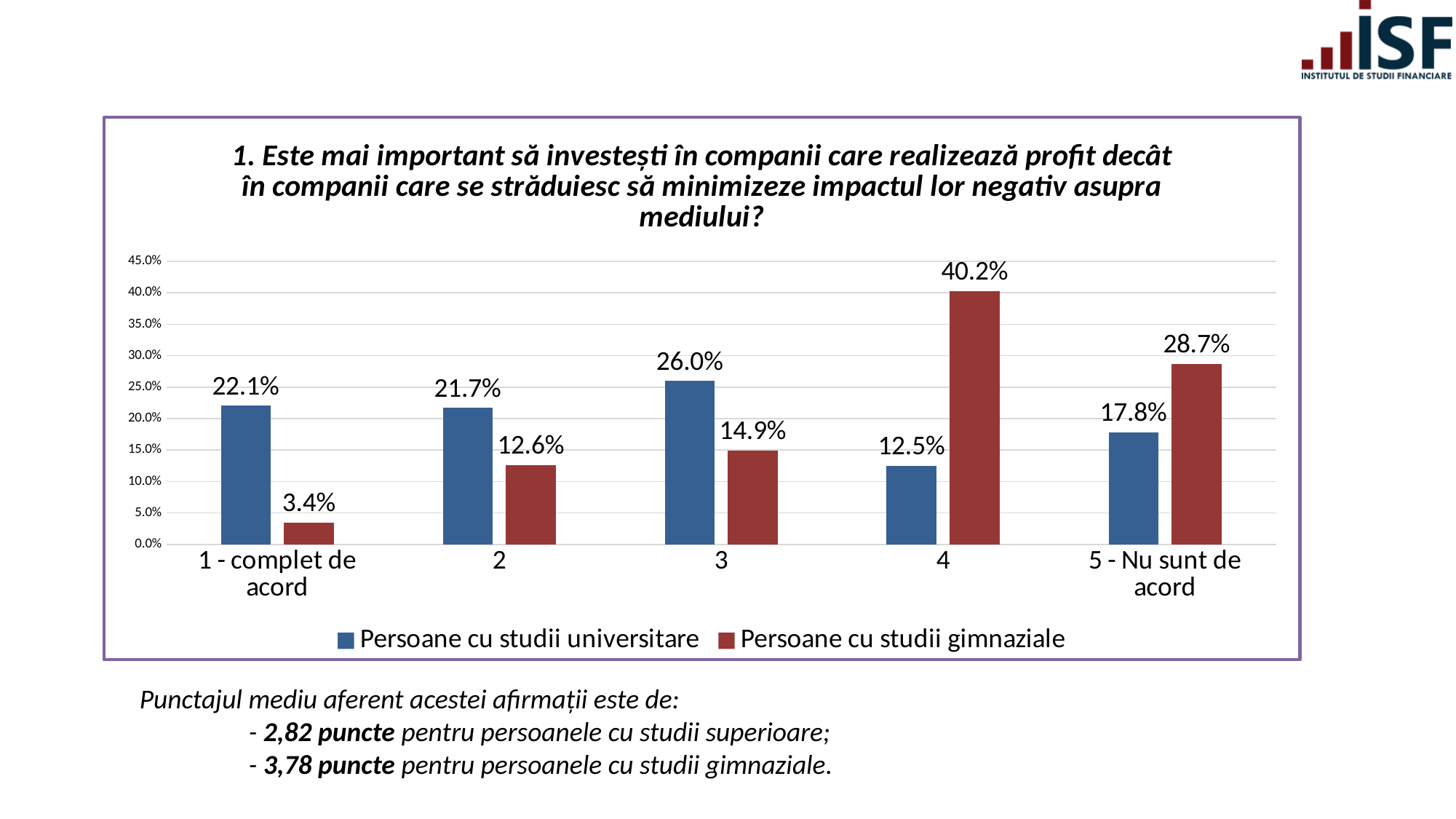
Is the value for 'Persoane cu studii gimnaziale' in category 2 greater or less than 15.0%? less Which category has the lowest value for 'Persoane cu studii gimnaziale'? 1 - complet de acord What is the value for 'Persoane cu studii gimnaziale' in category 4? 40.2% In category 3, which series has the larger value? Persoane cu studii universitare What is the difference between 'Persoane cu studii gimnaziale' and 'Persoane cu studii universitare' in category 4? 27.7% How many series does the legend list? 2 What kind of chart is shown on the slide? bar chart Which colour represents 'Persoane cu studii gimnaziale' in the chart? red What is the value for 'Persoane cu studii gimnaziale' in category '5 - Nu sunt de acord'? 28.7% How many categories are shown on the x axis? 5 What is the value for 'Persoane cu studii universitare' in category '1 - complet de acord'? 22.1% Which category has the highest value for 'Persoane cu studii universitare'? 3